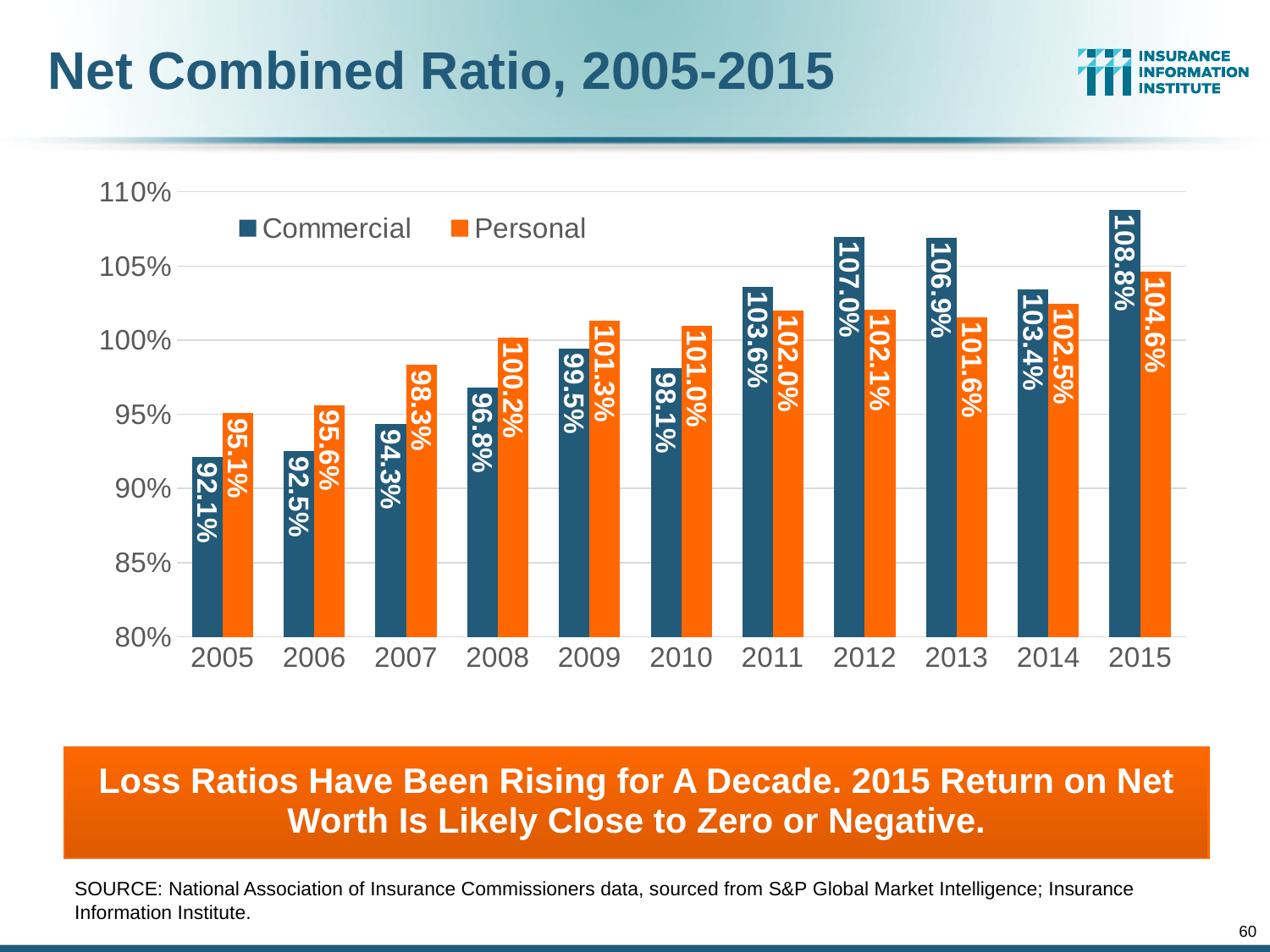
What is the Personal net combined ratio for 2008? 100.2% What is the Commercial net combined ratio for 2010? 98.1% Which year has the lowest Personal net combined ratio? 2005 Is the Commercial net combined ratio for 2009 greater or less than 100%? less What is the difference between the Personal and Commercial net combined ratios in 2005? 3.0% What kind of chart is shown on the slide? Bar chart Which year has the highest Commercial net combined ratio? 2015 What is the Commercial net combined ratio for 2015? 108.8% How many years are shown on the x axis? 11 How many series does the legend list? 2 Does the Commercial net combined ratio generally rise or fall from 2005 to 2015? Rise Which is larger in 2012, the Commercial or the Personal net combined ratio? Commercial